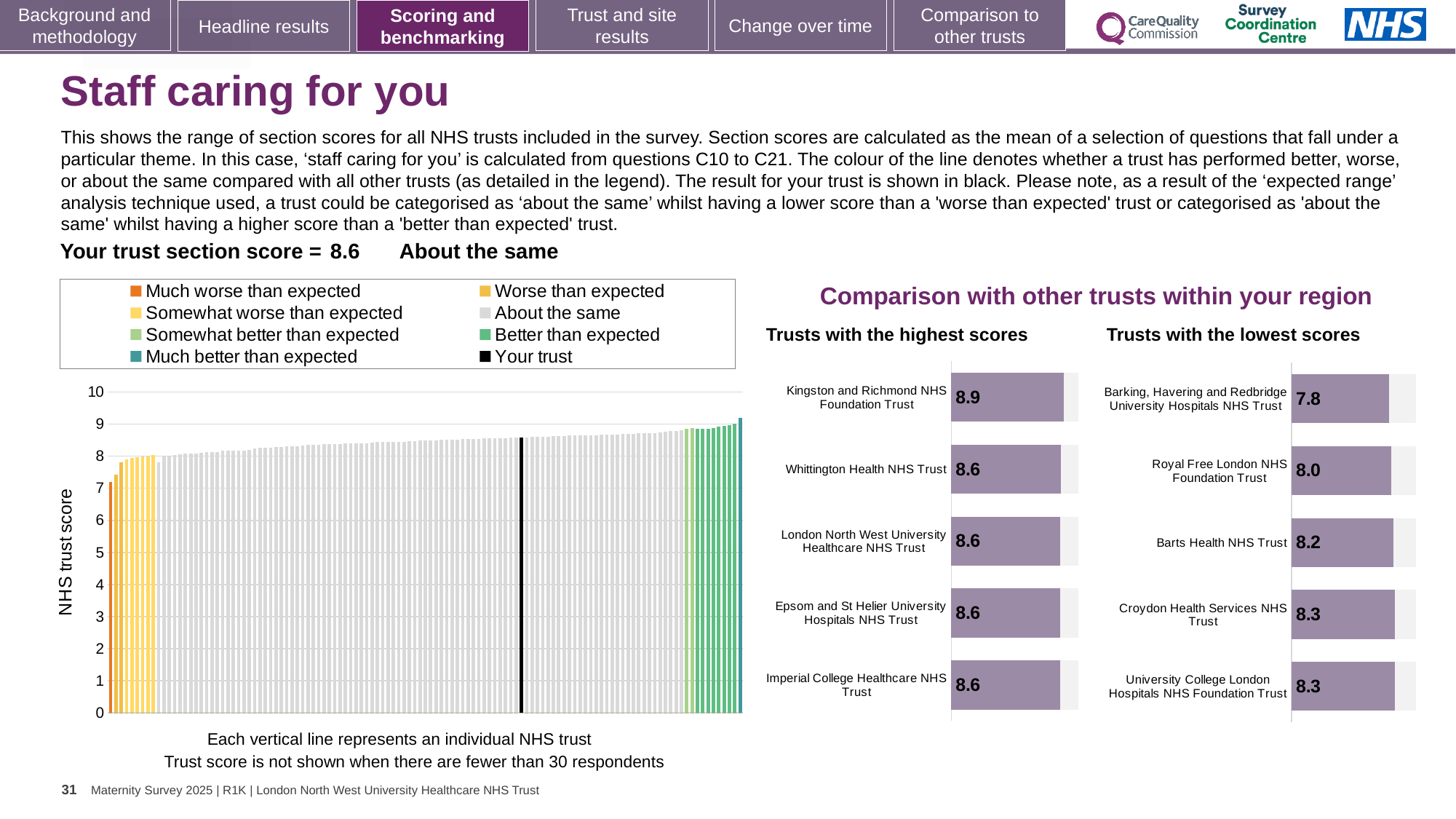
In the 'Trusts with the lowest scores' chart, what is the difference between the scores of Royal Free London NHS Foundation Trust and Barking, Havering and Redbridge University Hospitals NHS Trust? 0.2 In the 'Trusts with the lowest scores' chart, which has the larger score: Barts Health NHS Trust or Royal Free London NHS Foundation Trust? Barts Health NHS Trust What kind of chart is the main 'NHS trust score' chart on the left? Bar chart In the main 'NHS trust score' chart, do the values rise or fall from left to right? rise How many trusts are shown in the 'Trusts with the highest scores' chart? 5 How many entries does the legend of the main 'NHS trust score' chart list? 8 In the 'Trusts with the lowest scores' chart, which trust has the lowest score? Barking, Havering and Redbridge University Hospitals NHS Trust In the 'Trusts with the highest scores' chart, what is the score for Kingston and Richmond NHS Foundation Trust? 8.9 In the main 'NHS trust score' chart, is the value for the leftmost (orange) bar greater or less than 8? less What is your trust's section score for 'Staff caring for you'? 8.6 In the 'Trusts with the lowest scores' chart, what is the score for Barking, Havering and Redbridge University Hospitals NHS Trust? 7.8 In the 'Trusts with the highest scores' chart, which trust has the highest score? Kingston and Richmond NHS Foundation Trust